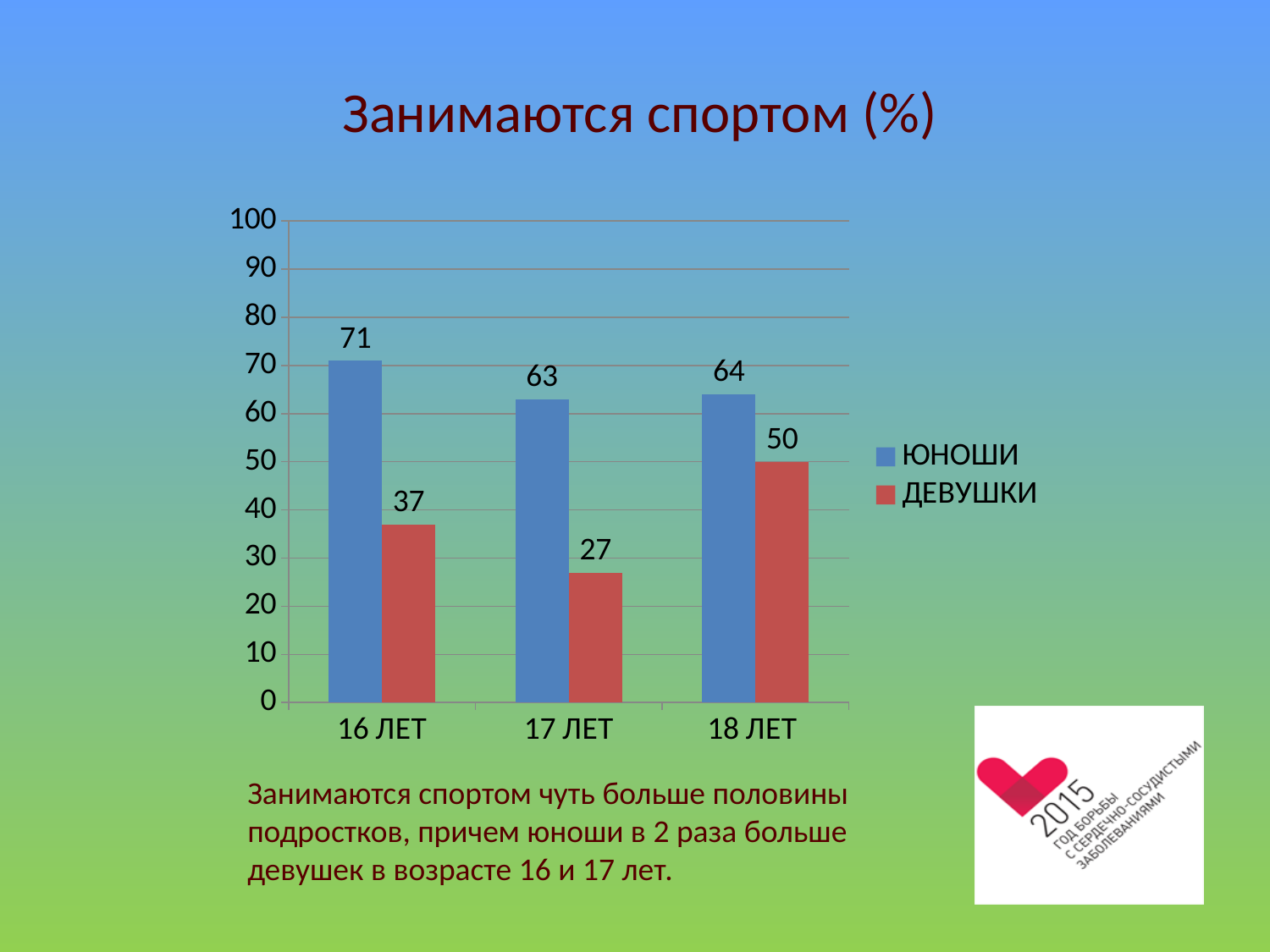
What is the value for ЮНОШИ at 16 ЛЕТ? 71 What kind of chart is shown on the slide? bar chart What is the difference between ЮНОШИ and ДЕВУШКИ at 17 ЛЕТ? 36 How many age groups are shown on the x axis? 3 Which age group has the highest value for ЮНОШИ? 16 ЛЕТ What is the value for ДЕВУШКИ at 17 ЛЕТ? 27 Which age group has the lowest value for ДЕВУШКИ? 17 ЛЕТ What is the title of the chart? Занимаются спортом (%) How many series does the legend list? 2 Which is larger at 18 ЛЕТ, ЮНОШИ or ДЕВУШКИ? ЮНОШИ What is the value for ДЕВУШКИ at 18 ЛЕТ? 50 Is the value for ДЕВУШКИ at 16 ЛЕТ greater or less than 40? less